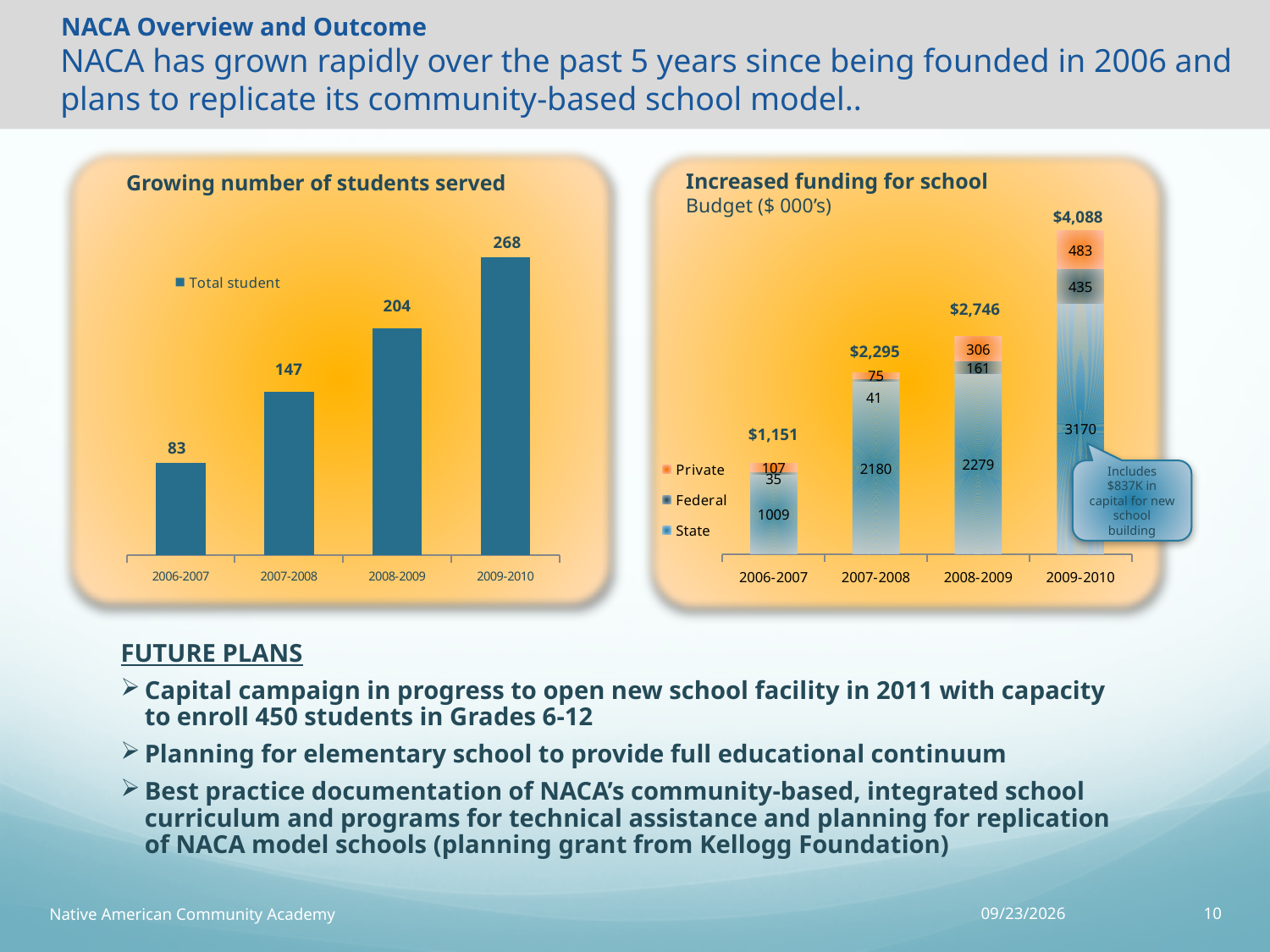
What kind of chart is the 'Growing number of students served' chart? bar chart In the 'Growing number of students served' chart, how many total students were served in 2008-2009? 204 In the 'Increased funding for school' chart, how many series does the legend list? 3 In the 'Increased funding for school' chart, which year has the highest total budget? 2009-2010 In the 'Growing number of students served' chart, how many school years are shown? 4 In the 'Growing number of students served' chart, which year has the lowest number of students? 2006-2007 In the 'Increased funding for school' chart, what is the State funding for 2009-2010? 3170 In the 'Growing number of students served' chart, do the values rise or fall from 2006-2007 to 2009-2010? rise In the 'Increased funding for school' chart, what is the difference between Private funding in 2009-2010 and 2008-2009? 177 In the 'Increased funding for school' chart, what is the total budget for 2008-2009? $2,746 In the 'Increased funding for school' chart, which is larger for 2008-2009: Federal or Private funding? Private In the 'Growing number of students served' chart, what is the difference in students between 2009-2010 and 2006-2007? 185